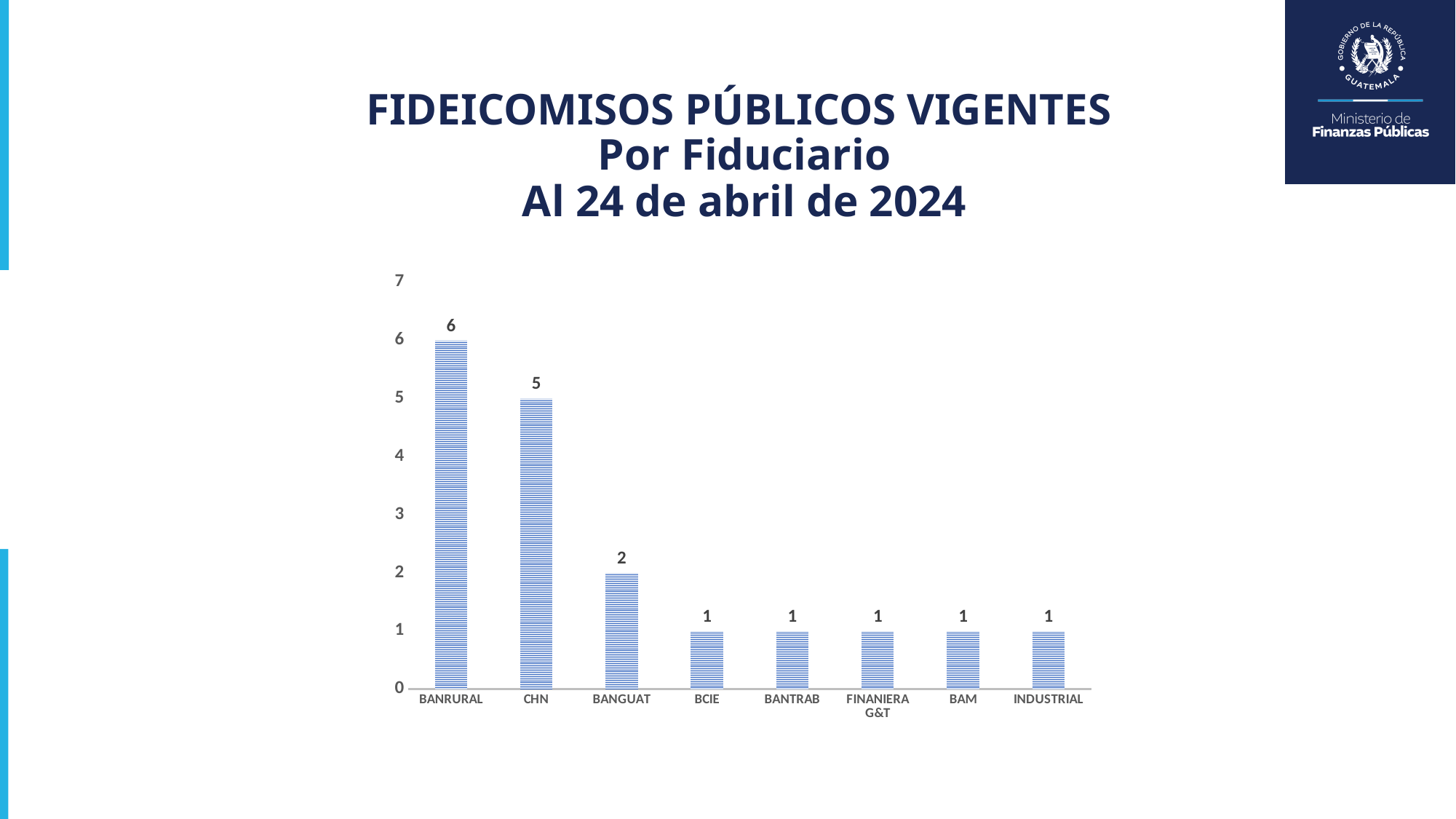
What is the value for BCIE? 1 What is the value for BANGUAT? 2 What date is given in the chart title? 24 de abril de 2024 What is the value for CHN? 5 Which is larger, the value for BANGUAT or the value for BAM? BANGUAT Do the values generally rise or fall from left to right along the x axis? Fall What is the difference between the values for CHN and BANGUAT? 3 What kind of chart is shown on the slide? Bar chart What is the value for BANRURAL? 6 What is the difference between the values for BANRURAL and CHN? 1 Which fiduciario has the highest value? BANRURAL How many categories are shown on the x axis? 8